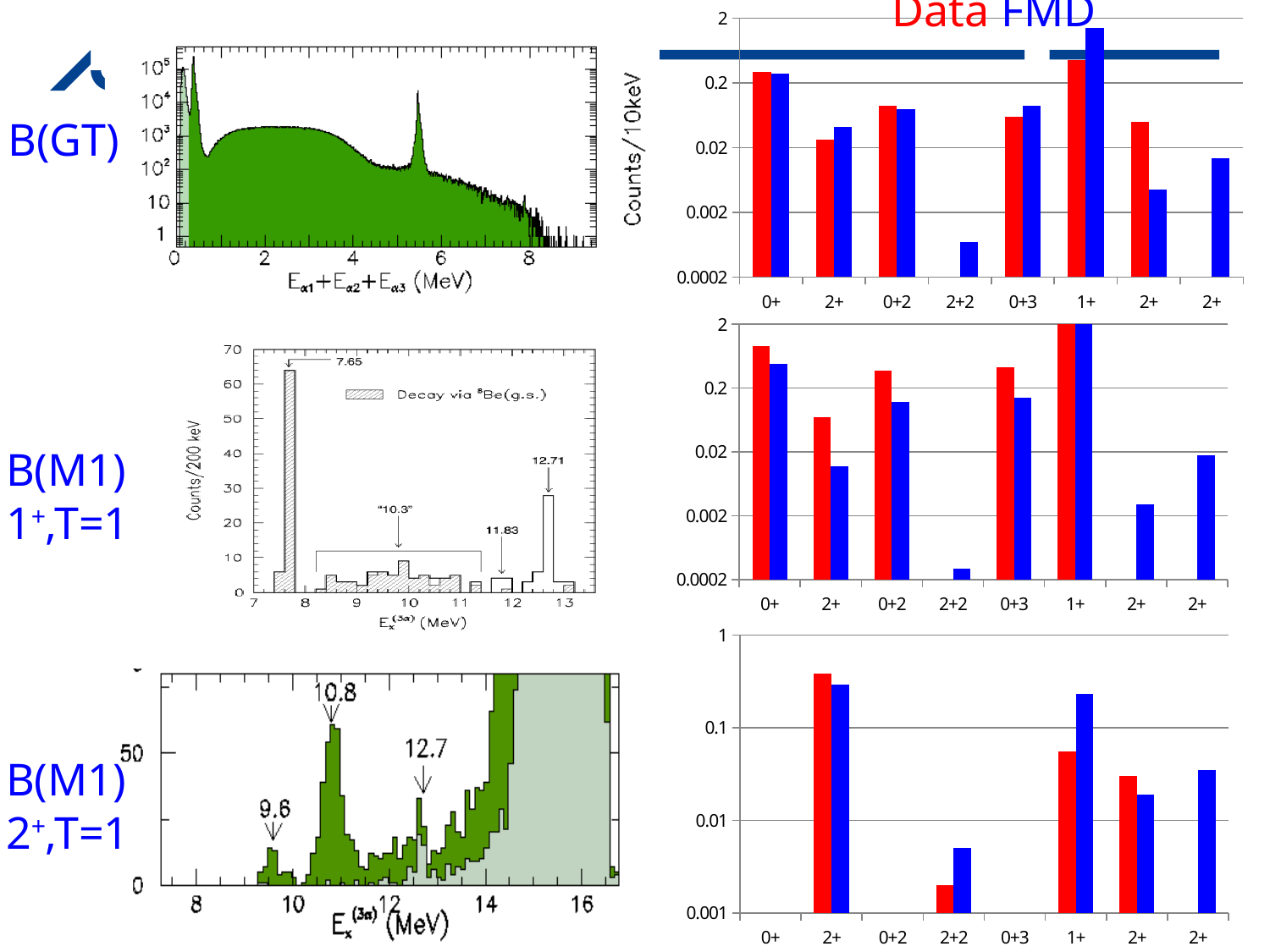
How many categories are shown on the x axis of the B(GT) bar chart at the top right? 8 In the B(GT) bar chart at the top right, is the FMD value for 2+2 greater or less than 0.002? less In the B(M1) 1+,T=1 bar chart in the middle right, is the Data value for 0+ greater or less than 0.2? greater In the middle-left histogram, is the peak labelled 7.65 greater or less than 60 counts per 200 keV? greater What are the two series named in the legend above the right-hand bar charts? Data and FMD In the B(M1) 1+,T=1 bar chart in the middle right, which series has the larger value for 0+, Data or FMD? Data What kind of chart is the B(GT) chart at the top right of the slide? bar chart How many series does the legend above the right-hand bar charts list? 2 In the B(M1) 2+,T=1 bar chart at the bottom right, which series has the larger value for 1+, Data or FMD? FMD In the B(GT) bar chart at the top right, which series has the larger value for 1+, Data or FMD? FMD